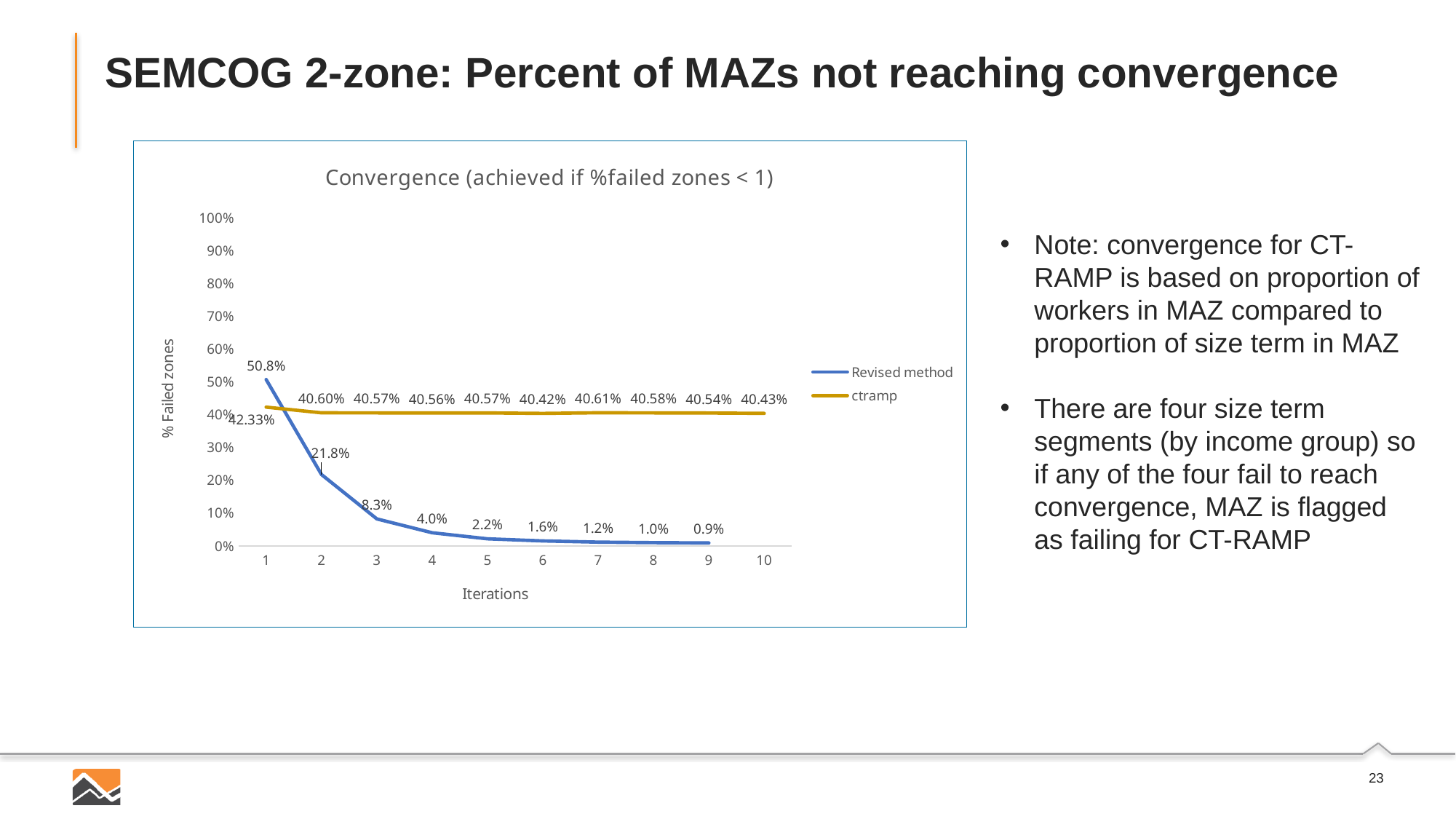
What kind of chart is shown on the slide? line chart Do the Revised method values rise or fall as the iterations increase? fall At which iteration is the Revised method value highest? 1 Is the value for ctramp at iteration 5 greater or less than 50%? less What is the difference between the Revised method values at iteration 1 and iteration 2? 29.0% What is the value for ctramp at iteration 10? 40.43% What is the value for the Revised method at iteration 9? 0.9% At which iteration is the ctramp value highest? 1 What is the value for the Revised method at iteration 1? 50.8% What is the title of the y axis? % Failed zones How many series does the legend list? 2 At iteration 5, which series has the higher value, Revised method or ctramp? ctramp